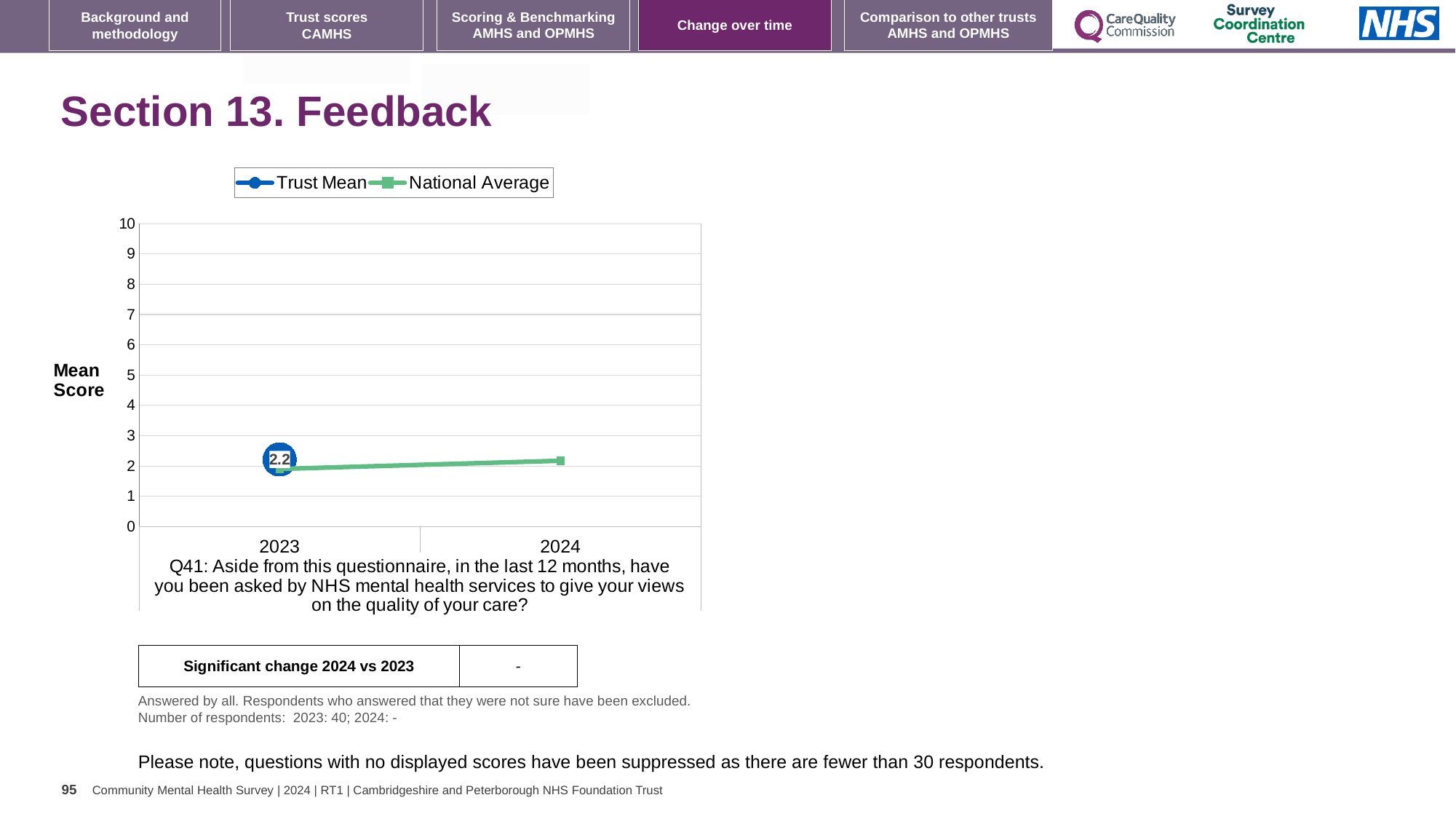
Is the Trust Mean value for 2023 greater or less than 2? greater Is the National Average value for 2023 greater or less than 1? greater What is the label on the y axis of the chart? Mean Score Is the National Average value for 2023 greater or less than 3? less How many series does the legend list? 2 What kind of chart is shown on the slide? Line chart What are the two series named in the legend? Trust Mean and National Average What is the highest value shown on the y axis? 10 How many years are shown on the x axis? 2 What is the Trust Mean value for 2023? 2.2 Does the National Average rise or fall from 2023 to 2024? Rise